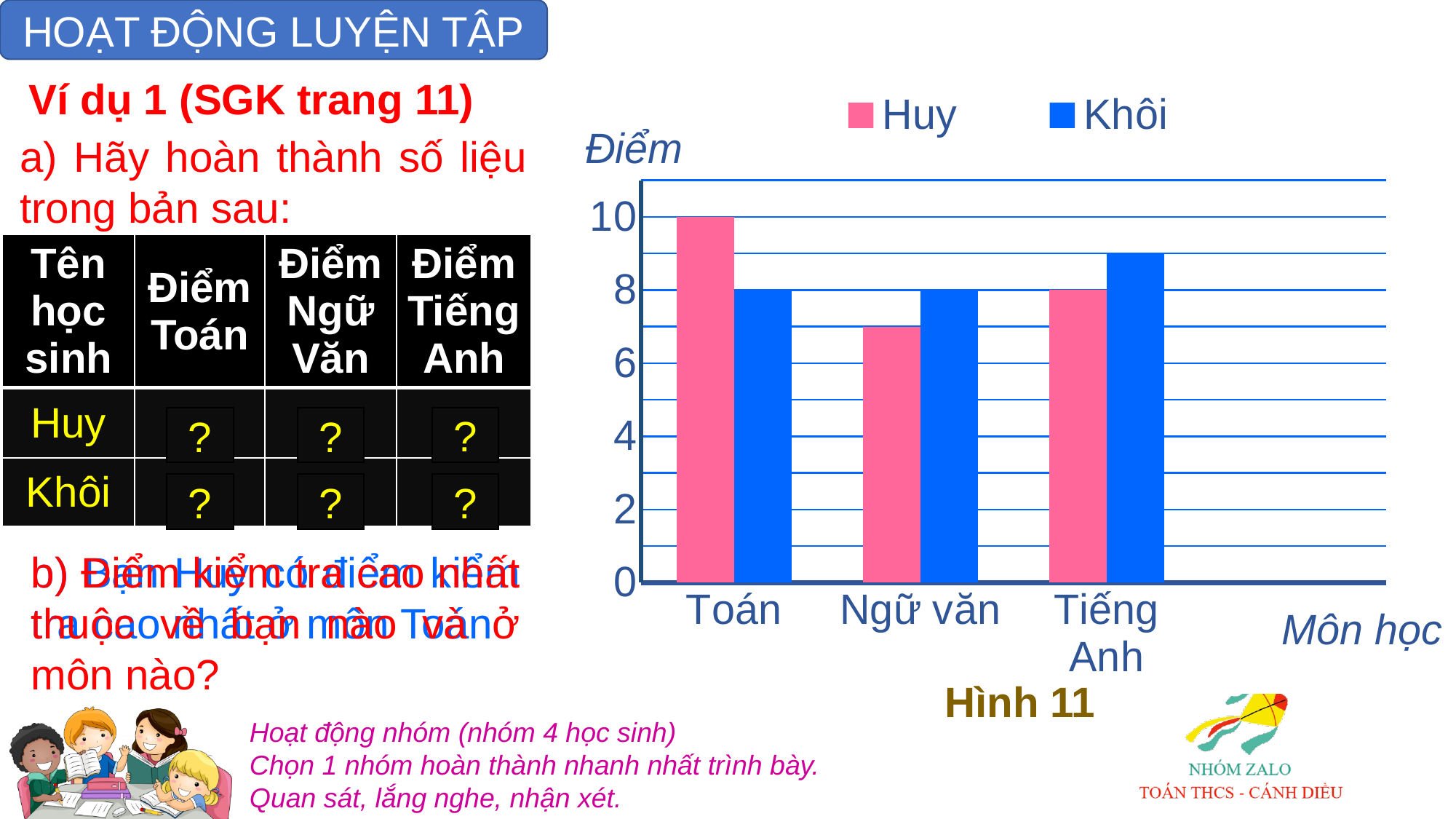
How many series does the legend list? 2 What is the difference between Huy's and Khôi's scores in Toán? 2 Is Khôi's score in Tiếng Anh greater or less than 8? greater What is Huy's score in Toán? 10 What is Khôi's score in Toán? 8 Who has the higher score in Ngữ văn, Huy or Khôi? Khôi What kind of chart is shown on the slide? bar chart Is Huy's score in Ngữ văn greater or less than 8? less What is Huy's score in Tiếng Anh? 8 What is Khôi's score in Ngữ văn? 8 In which subject does Huy have the highest score? Toán How many subjects (categories) are shown on the x axis? 3